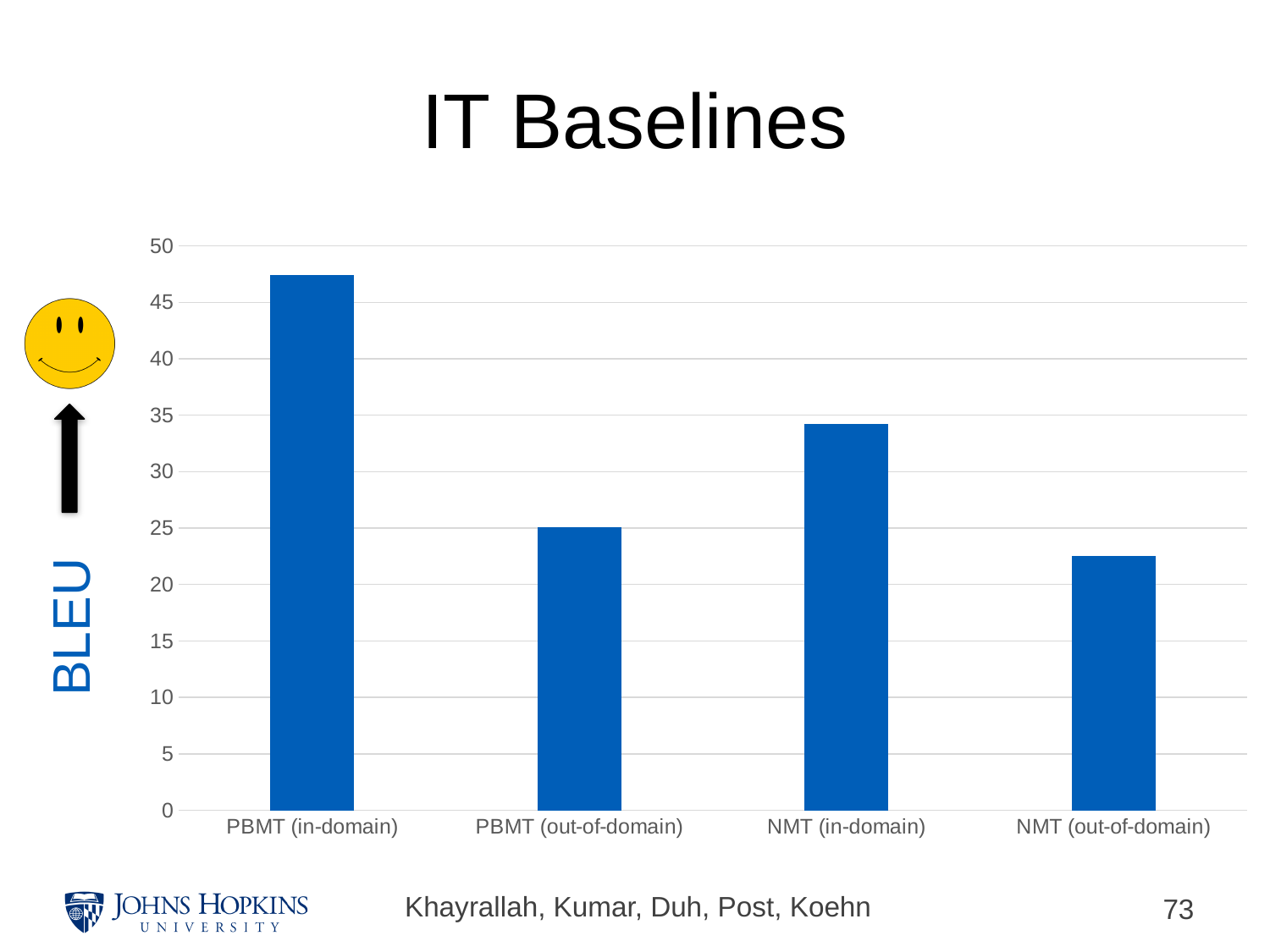
Is the BLEU value for PBMT (in-domain) greater or less than 45? greater Which category has the lowest BLEU score? NMT (out-of-domain) Is the BLEU value for NMT (in-domain) greater or less than 30? greater Is the BLEU value for NMT (out-of-domain) greater or less than 25? less Which category has the highest BLEU score? PBMT (in-domain) What is the title of the chart? IT Baselines Which has a higher BLEU score, PBMT (in-domain) or NMT (in-domain)? PBMT (in-domain) Which has a higher BLEU score, PBMT (out-of-domain) or NMT (in-domain)? NMT (in-domain) What kind of chart is shown on the slide? bar chart How many categories are shown on the x axis? 4 What is the label on the y axis? BLEU